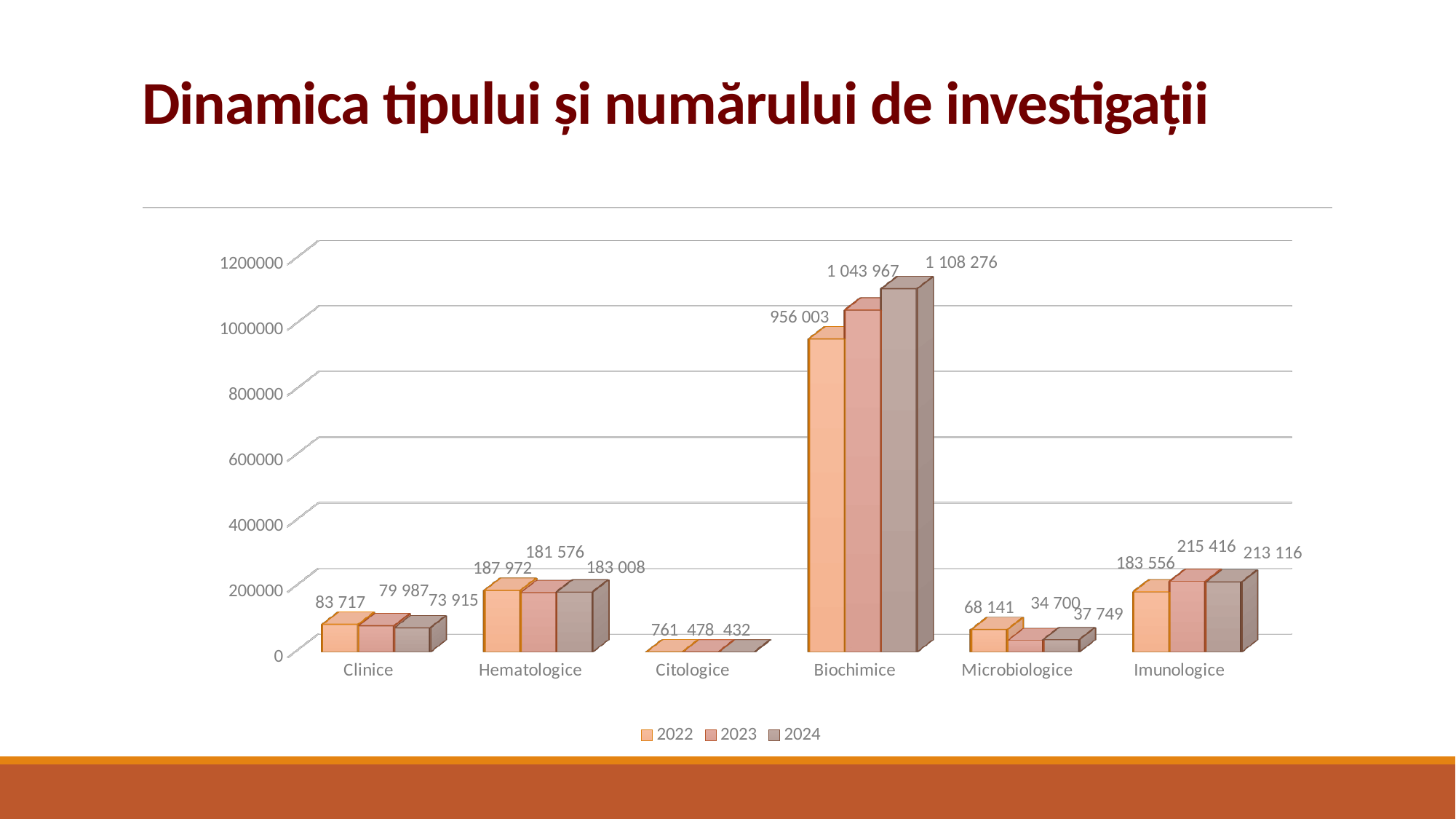
Which category has the highest value in 2022? Biochimice What is the value for Citologice in 2022? 761 What is the value for Microbiologice in 2023? 34 700 What kind of chart is shown on the slide? Bar chart What is the value for Imunologice in 2023? 215 416 Which category has the lowest value in 2024? Citologice Which is larger for Hematologice: the 2022 value or the 2024 value? 2022 Is the value for Imunologice in 2023 greater or less than 200000? greater What is the value for Biochimice in 2024? 1 108 276 How many series does the legend list? 3 What is the difference between the 2024 and 2023 values for Biochimice? 64 309 How many categories are shown on the x axis? 6